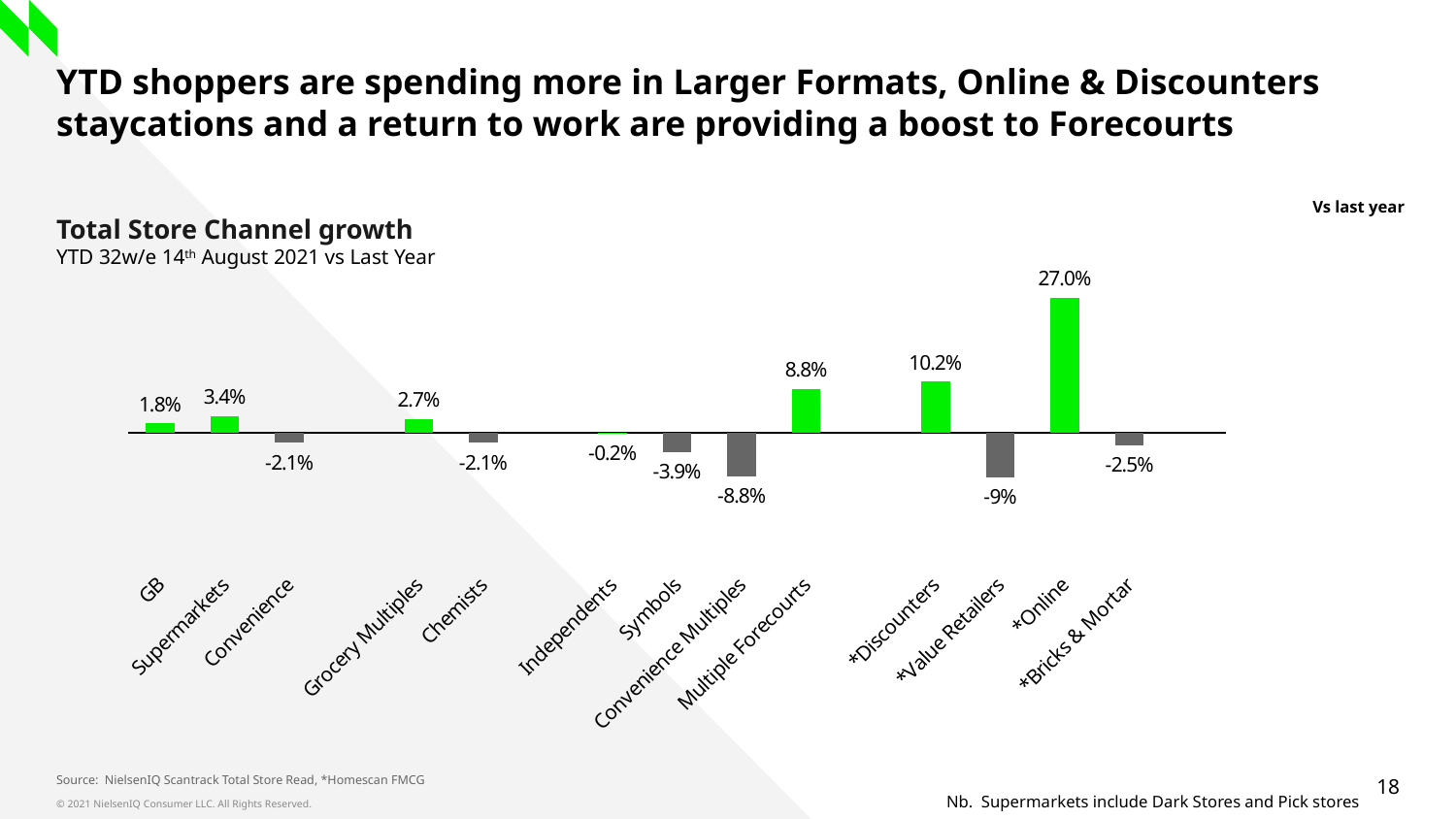
How many categories are shown on the chart? 13 Which is larger, the value for *Discounters or the value for Multiple Forecourts? *Discounters What is the value for *Online? 27.0% What is the difference between the values for Supermarkets and GB? 1.6 percentage points What is the value for *Discounters? 10.2% What is the title of the chart? Total Store Channel growth What is the value for Supermarkets? 3.4% What kind of chart is shown on the slide? Bar chart What is the difference between the values for *Online and *Discounters? 16.8 percentage points Which category has the highest value? *Online What is the value for Convenience Multiples? -8.8% Which category has the lowest value? *Value Retailers